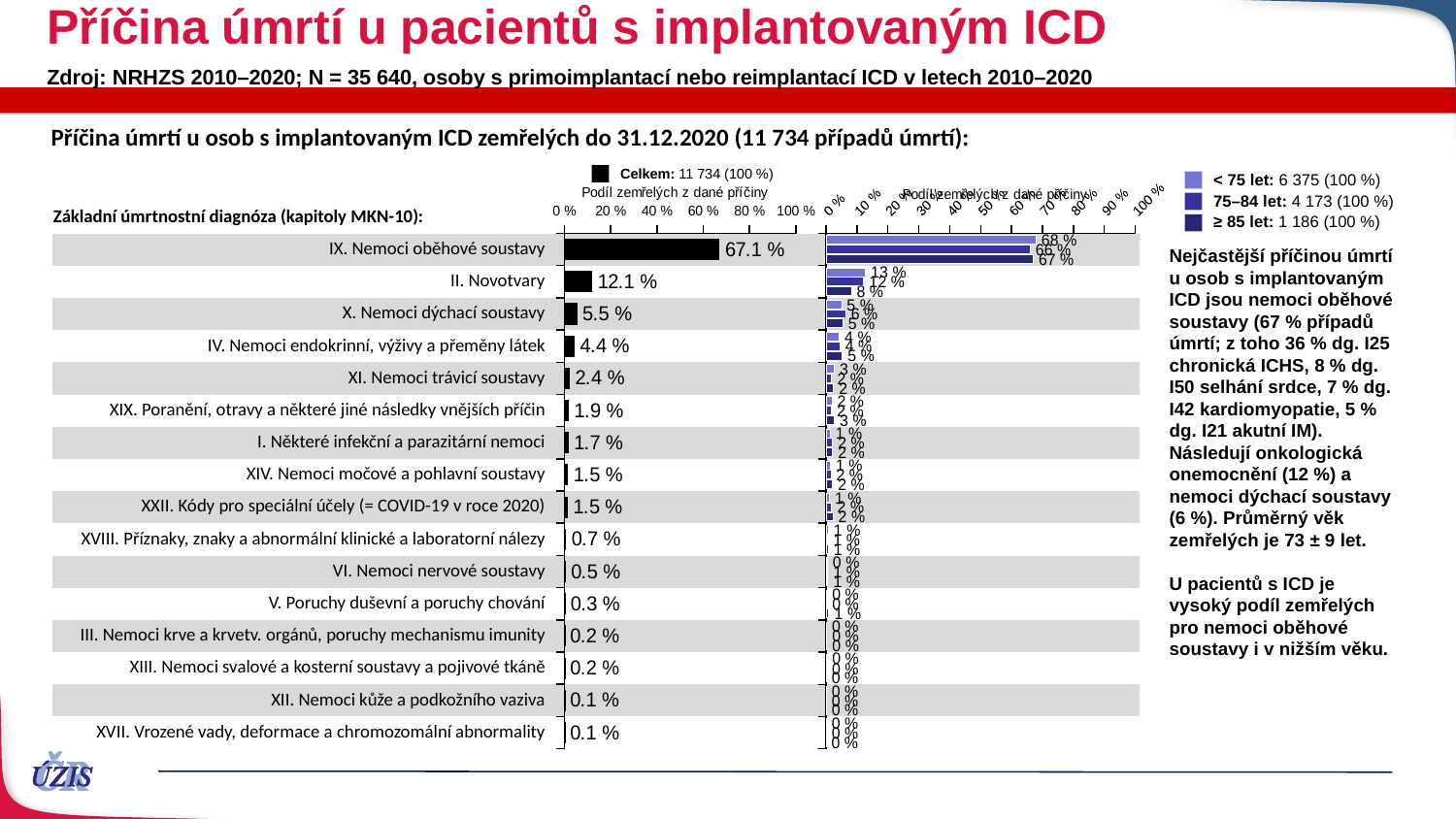
What kind of chart is the left chart (Celkem)? bar chart How many age-group series does the legend of the right chart list? 3 In the left chart (Celkem), what is the share of deaths for 'XXII. Kódy pro speciální účely (= COVID-19 v roce 2020)'? 1.5 % According to the legend of the left chart, what is the total number of deaths (Celkem)? 11 734 (100 %) In the left chart (Celkem), what is the share of deaths for 'IX. Nemoci oběhové soustavy'? 67.1 % In the left chart (Celkem), what is the share of deaths for 'II. Novotvary'? 12.1 % In the left chart (Celkem), which diagnosis chapter has the highest share of deaths? IX. Nemoci oběhové soustavy In the left chart (Celkem), what is the difference between the shares for 'IX. Nemoci oběhové soustavy' and 'II. Novotvary'? 55.0 % In the right chart, what is the share of deaths for 'IX. Nemoci oběhové soustavy' in the '< 75 let' age group? 68 % In the left chart (Celkem), is the value for 'IX. Nemoci oběhové soustavy' greater or less than 60 %? greater In the left chart (Celkem), which has a larger share: 'X. Nemoci dýchací soustavy' or 'IV. Nemoci endokrinní, výživy a přeměny látek'? X. Nemoci dýchací soustavy How many diagnosis chapters (categories) are listed in the left chart (Celkem)? 16